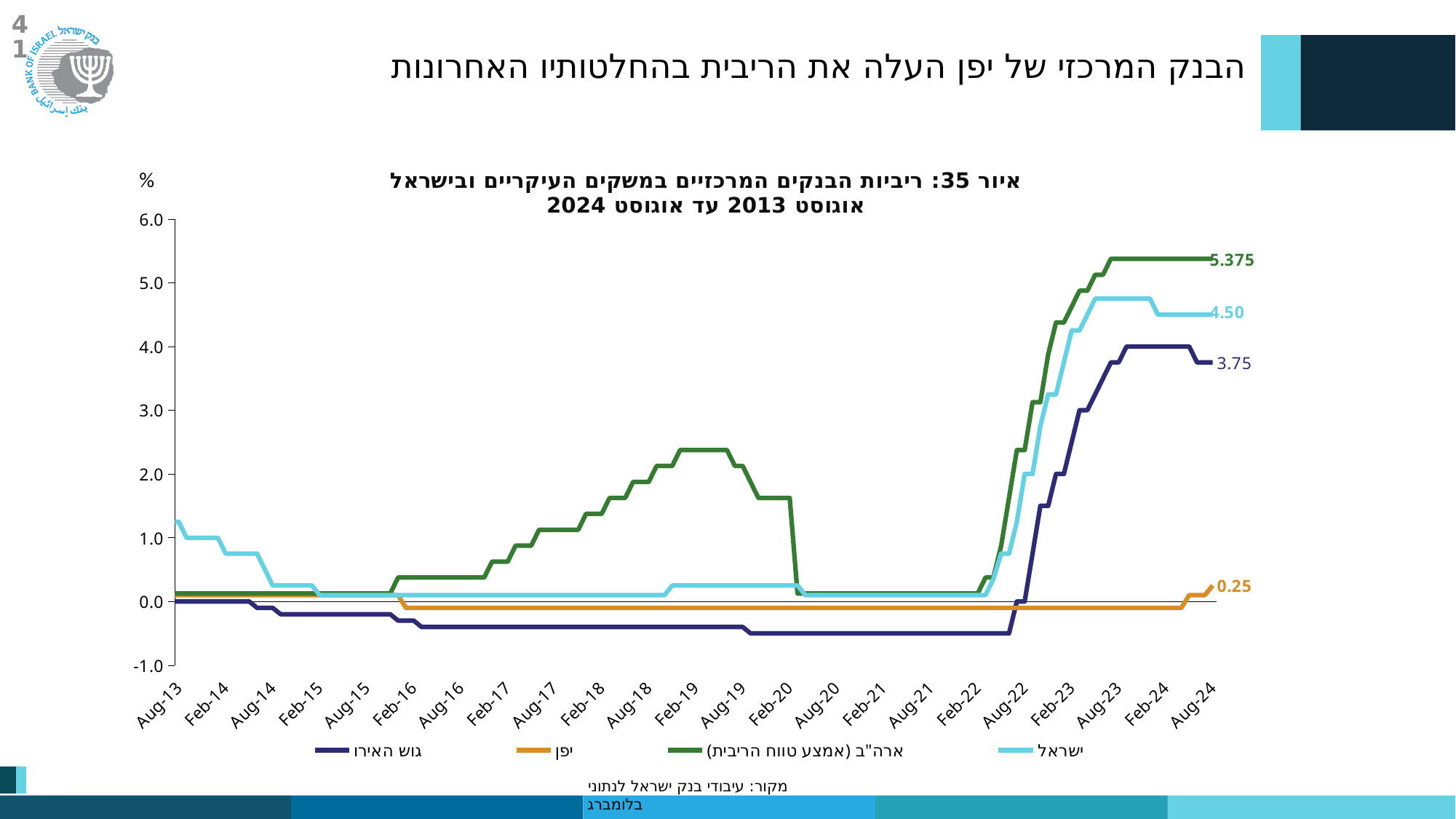
What is the latest value shown for ארה"ב (אמצע טווח הריבית)? 5.375 What is the difference between the latest values of ארה"ב (אמצע טווח הריבית) and ישראל? 0.875 Does the ישראל series rise or fall between Feb-22 and Aug-23? rise How many series does the legend list? 4 What is the latest value shown for גוש האירו? 3.75 What type of chart is shown on the slide? line chart Is the value for ארה"ב (אמצע טווח הריבית) in Feb-19 greater or less than 2.0? greater Which series has the highest value at the end of the chart (Aug-24)? ארה"ב (אמצע טווח הריבית) What is the latest value shown for יפן? 0.25 What is the latest value shown for ישראל? 4.50 Which series has the lowest value at the end of the chart (Aug-24)? יפן What unit is shown on the y axis of the chart? %